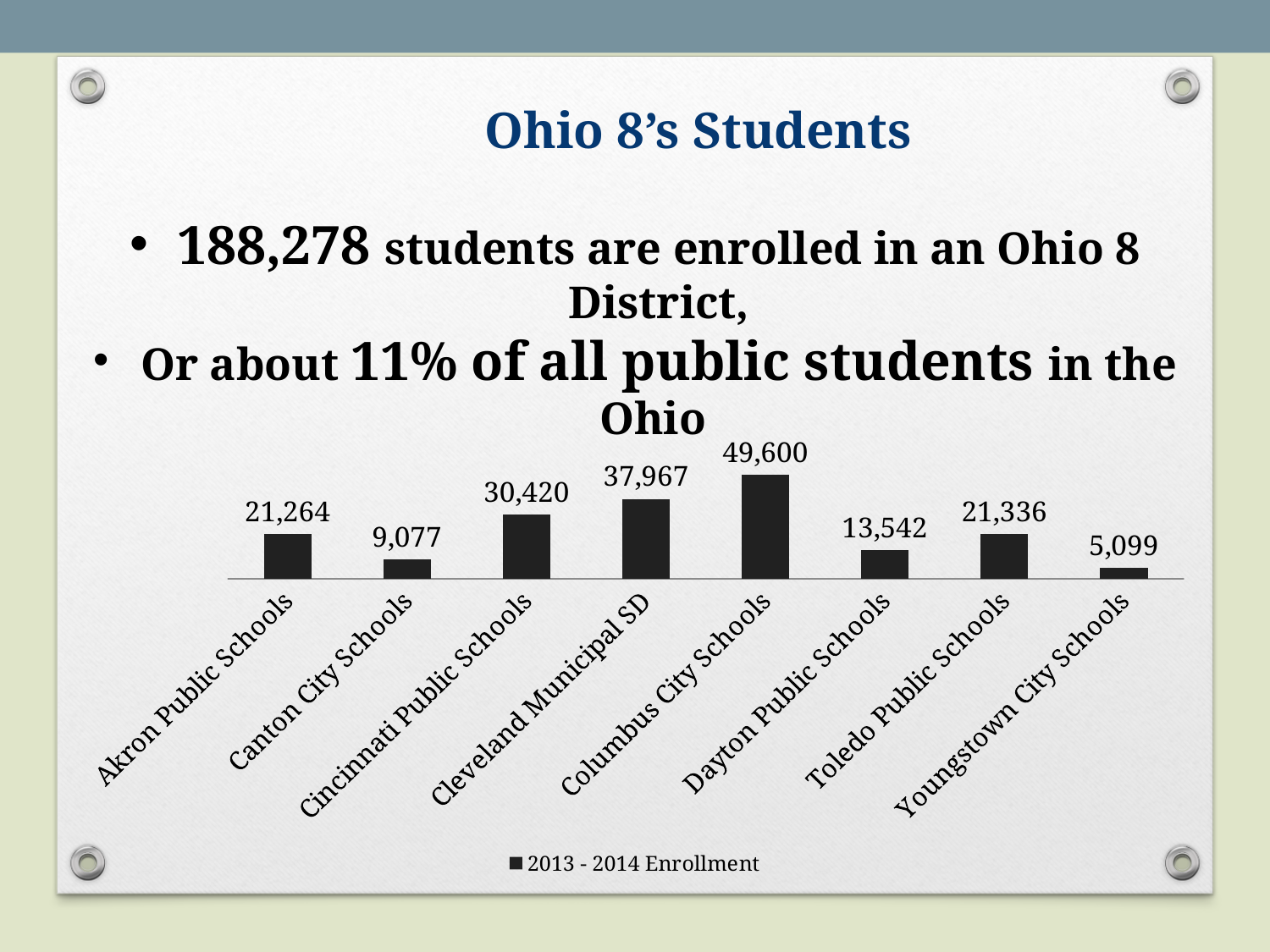
Which district has the highest enrollment in the chart? Columbus City Schools What is the difference in enrollment between Cincinnati Public Schools and Dayton Public Schools? 16,878 What is the legend entry for the series in the chart? 2013 - 2014 Enrollment How many districts are shown in the chart? 8 What is the 2013 - 2014 enrollment for Cleveland Municipal SD? 37,967 What is the 2013 - 2014 enrollment for Columbus City Schools? 49,600 What is the difference in enrollment between Columbus City Schools and Cleveland Municipal SD? 11,633 How many series does the legend list? 1 Which has a larger enrollment, Akron Public Schools or Toledo Public Schools? Toledo Public Schools What kind of chart is shown on the slide? Bar chart Which district has the lowest enrollment in the chart? Youngstown City Schools What is the 2013 - 2014 enrollment for Canton City Schools? 9,077